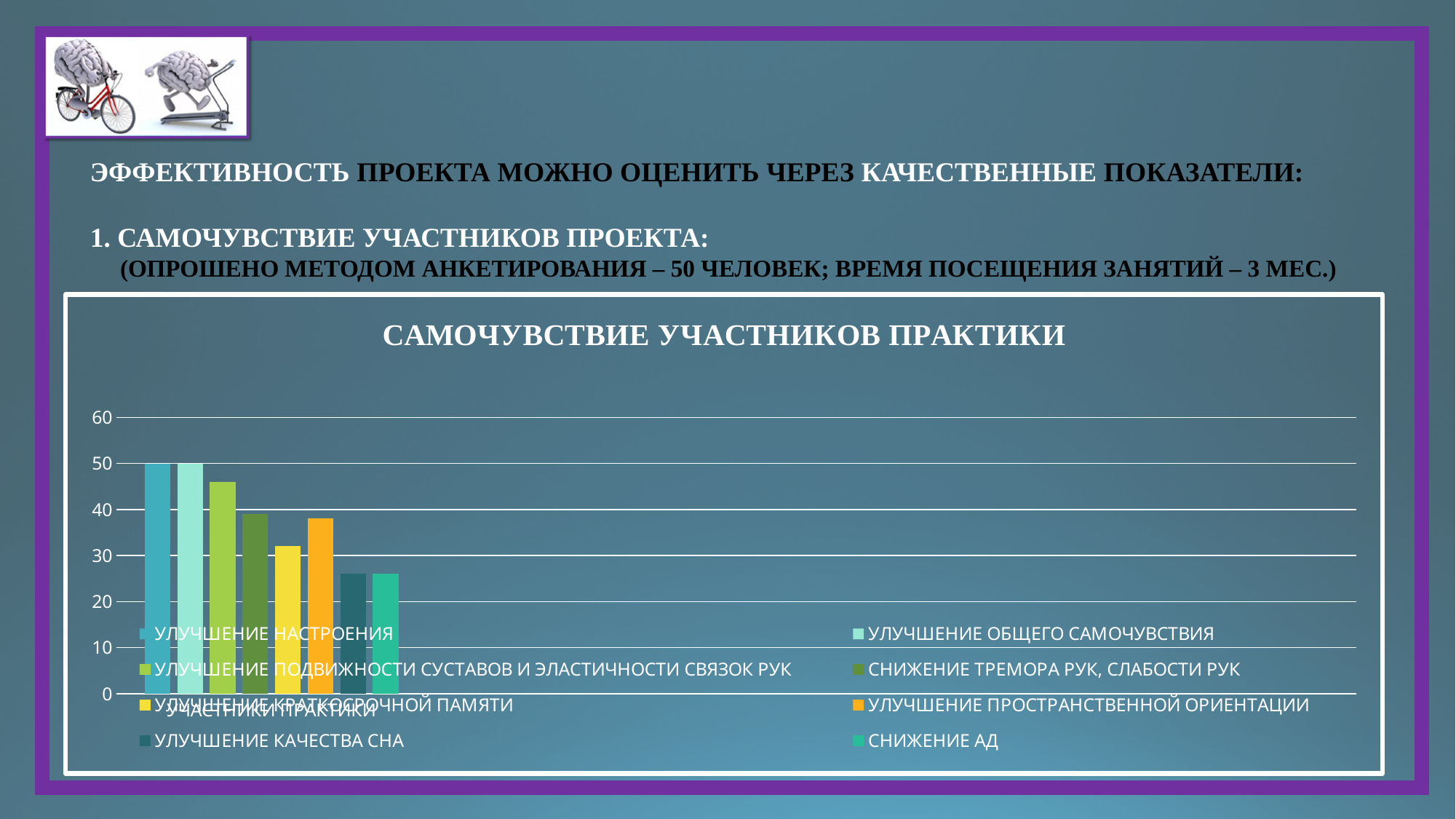
What is the value for УЛУЧШЕНИЕ ОБЩЕГО САМОЧУВСТВИЯ? 50 What type of chart is shown on the slide? bar chart Which is larger: УЛУЧШЕНИЕ КРАТКОСРОЧНОЙ ПАМЯТИ or УЛУЧШЕНИЕ ПРОСТРАНСТВЕННОЙ ОРИЕНТАЦИИ? УЛУЧШЕНИЕ ПРОСТРАНСТВЕННОЙ ОРИЕНТАЦИИ Is the value for УЛУЧШЕНИЕ КРАТКОСРОЧНОЙ ПАМЯТИ greater or less than 30? greater Is the value for СНИЖЕНИЕ АД greater or less than 20? greater Which is larger: УЛУЧШЕНИЕ ПОДВИЖНОСТИ СУСТАВОВ И ЭЛАСТИЧНОСТИ СВЯЗОК РУК or СНИЖЕНИЕ ТРЕМОРА РУК, СЛАБОСТИ РУК? УЛУЧШЕНИЕ ПОДВИЖНОСТИ СУСТАВОВ И ЭЛАСТИЧНОСТИ СВЯЗОК РУК Is the value for УЛУЧШЕНИЕ КАЧЕСТВА СНА greater or less than 30? less What is the value for УЛУЧШЕНИЕ НАСТРОЕНИЯ? 50 What is the title of the chart? САМОЧУВСТВИЕ УЧАСТНИКОВ ПРАКТИКИ How many series does the chart legend list? 8